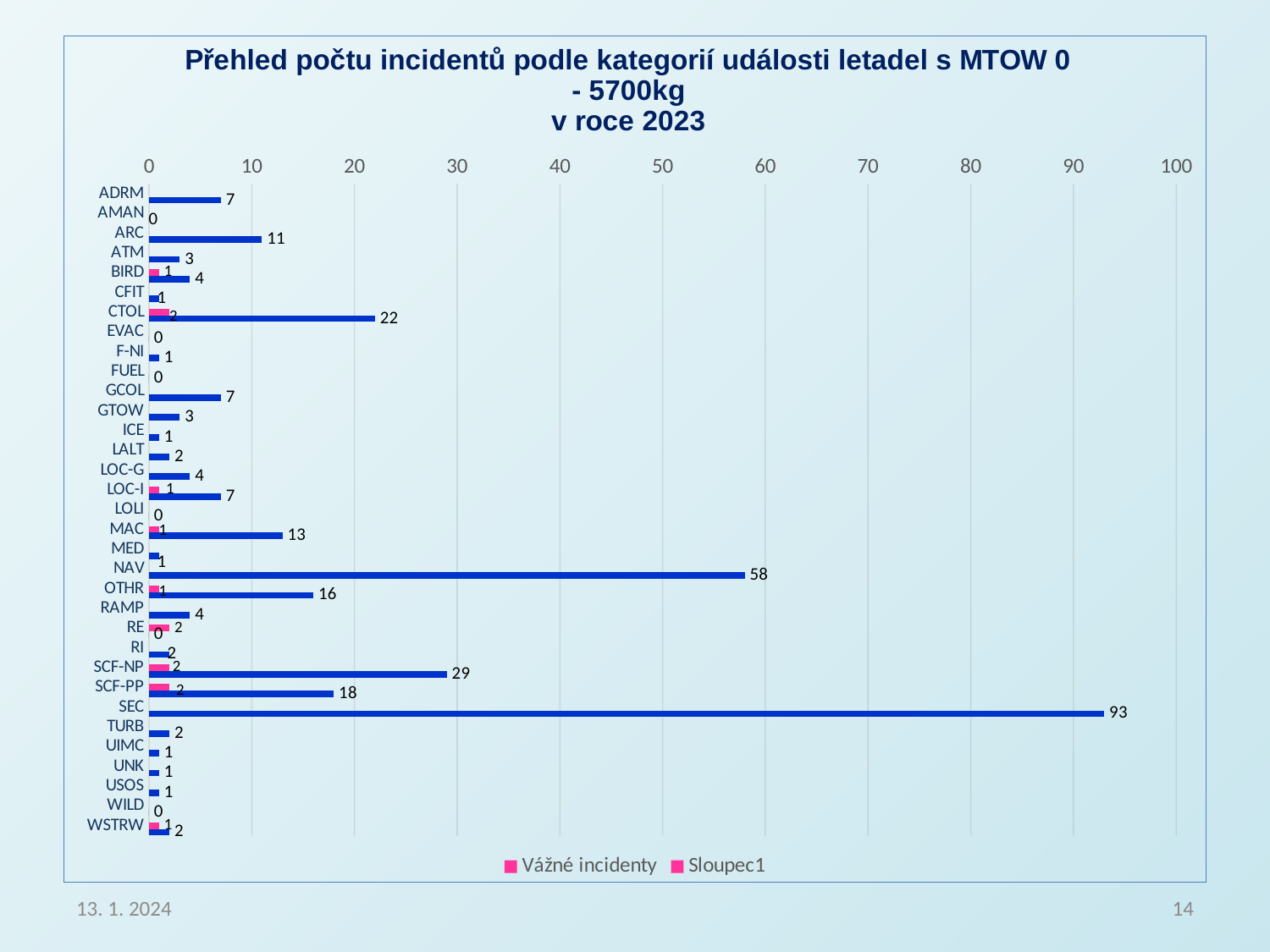
Which category has the highest blue bar value? SEC What is the value of the pink (Vážné incidenty) bar for SCF-PP? 2 What kind of chart is shown on the slide? bar chart Is the blue bar value for NAV greater or less than 50? greater What is the value of the blue bar for SCF-NP? 29 What is the value of the blue bar for SEC? 93 What is the value of the blue bar for NAV? 58 How many series does the legend list? 2 How many categories are listed on the vertical axis? 33 What is the value of the blue bar for CTOL? 22 What is the difference between the blue bar values for SEC and NAV? 35 Which has a larger blue bar value, SCF-NP or SCF-PP? SCF-NP